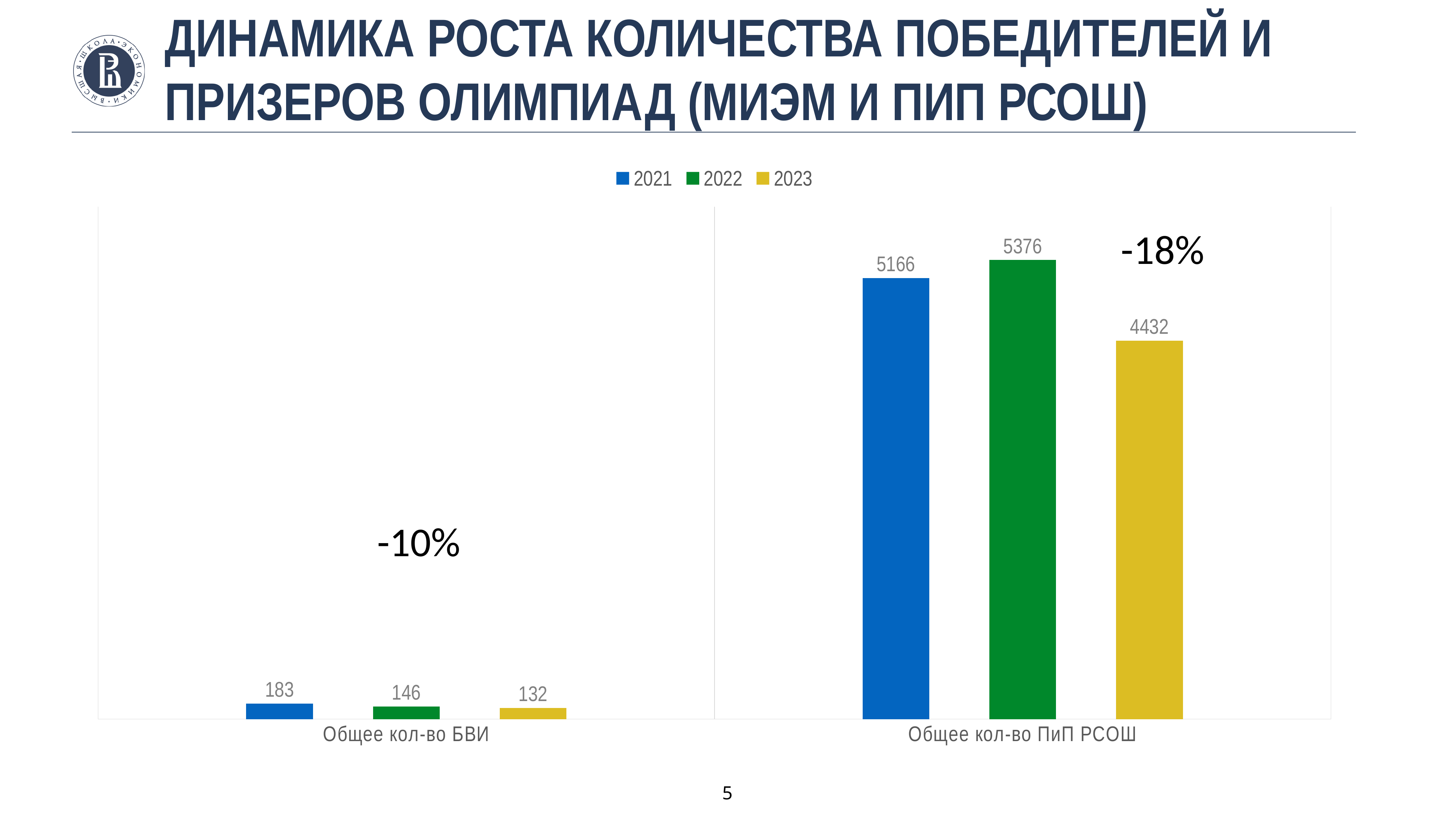
What kind of chart is shown on the slide? Bar chart What is the difference between the 2021 and 2023 values in the category "Общее кол-во БВИ"? 51 What is the difference between the 2022 and 2023 values in the category "Общее кол-во ПиП РСОШ"? 944 What is the value for 2023 in the category "Общее кол-во ПиП РСОШ"? 4432 Which is larger in the category "Общее кол-во ПиП РСОШ": the 2021 value or the 2022 value? 2022 How many series does the legend list? 3 Which year has the lowest value in the category "Общее кол-во БВИ"? 2023 What percentage change is annotated next to the "Общее кол-во ПиП РСОШ" bars? -18% What is the value for 2021 in the category "Общее кол-во БВИ"? 183 Which year has the highest value in the category "Общее кол-во ПиП РСОШ"? 2022 How many categories are shown on the x axis? 2 What is the value for 2022 in the category "Общее кол-во ПиП РСОШ"? 5376